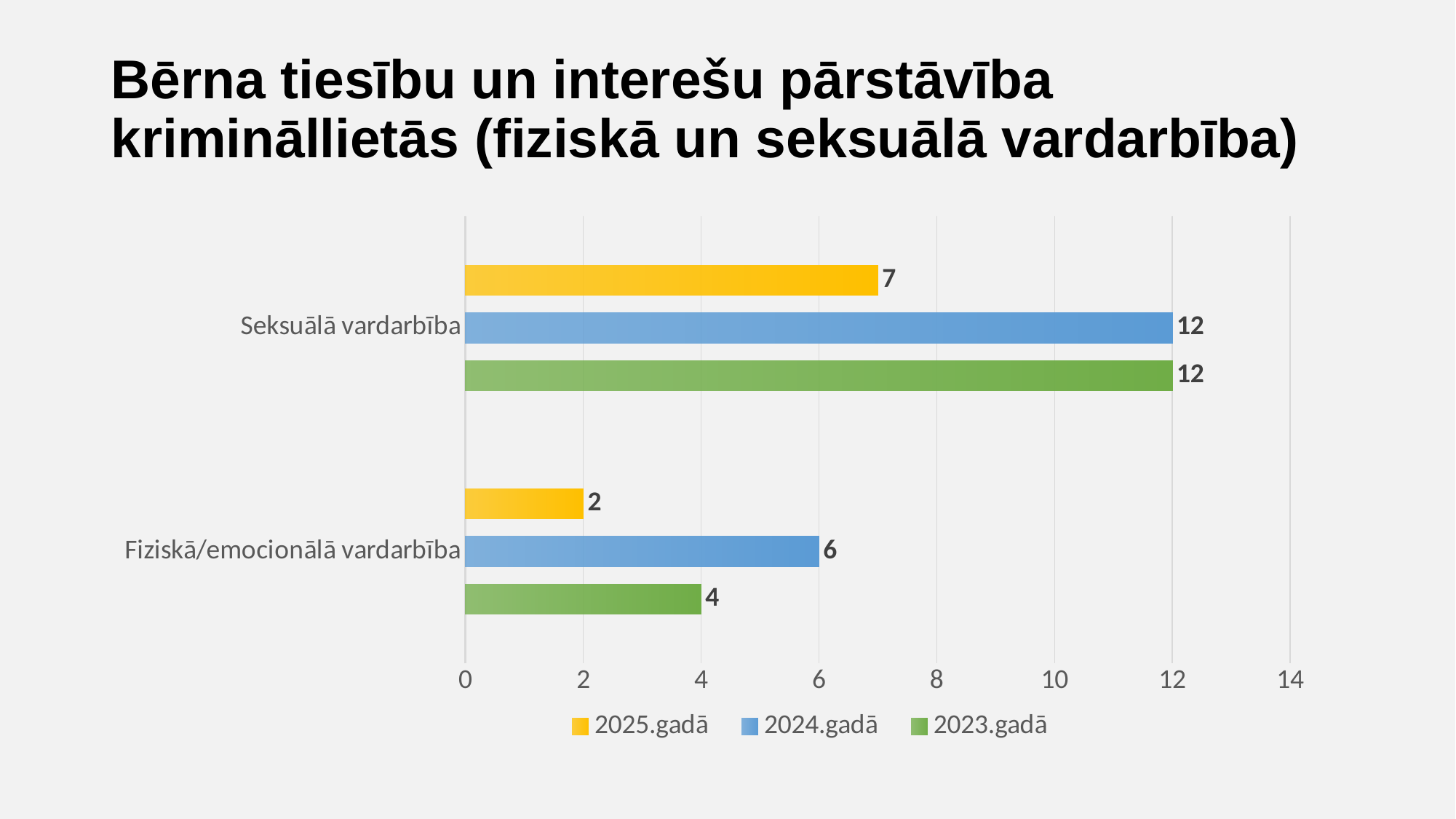
What is the value for Seksuālā vardarbība in 2023.gadā? 12 What is the value for Fiziskā/emocionālā vardarbība in 2023.gadā? 4 How many series does the legend list? 3 What is the value for Fiziskā/emocionālā vardarbība in 2024.gadā? 6 What kind of chart is shown on the slide? Bar chart Which is larger for 2025.gadā: Seksuālā vardarbība or Fiziskā/emocionālā vardarbība? Seksuālā vardarbība Which series has the lowest value for Fiziskā/emocionālā vardarbība? 2025.gadā What is the difference between the 2024.gadā and 2023.gadā values for Fiziskā/emocionālā vardarbība? 2 How many categories are shown on the chart? 2 What is the value for Seksuālā vardarbība in 2025.gadā? 7 What is the difference between the 2024.gadā and 2025.gadā values for Seksuālā vardarbība? 5 Which colour represents 2024.gadā in the legend? Blue